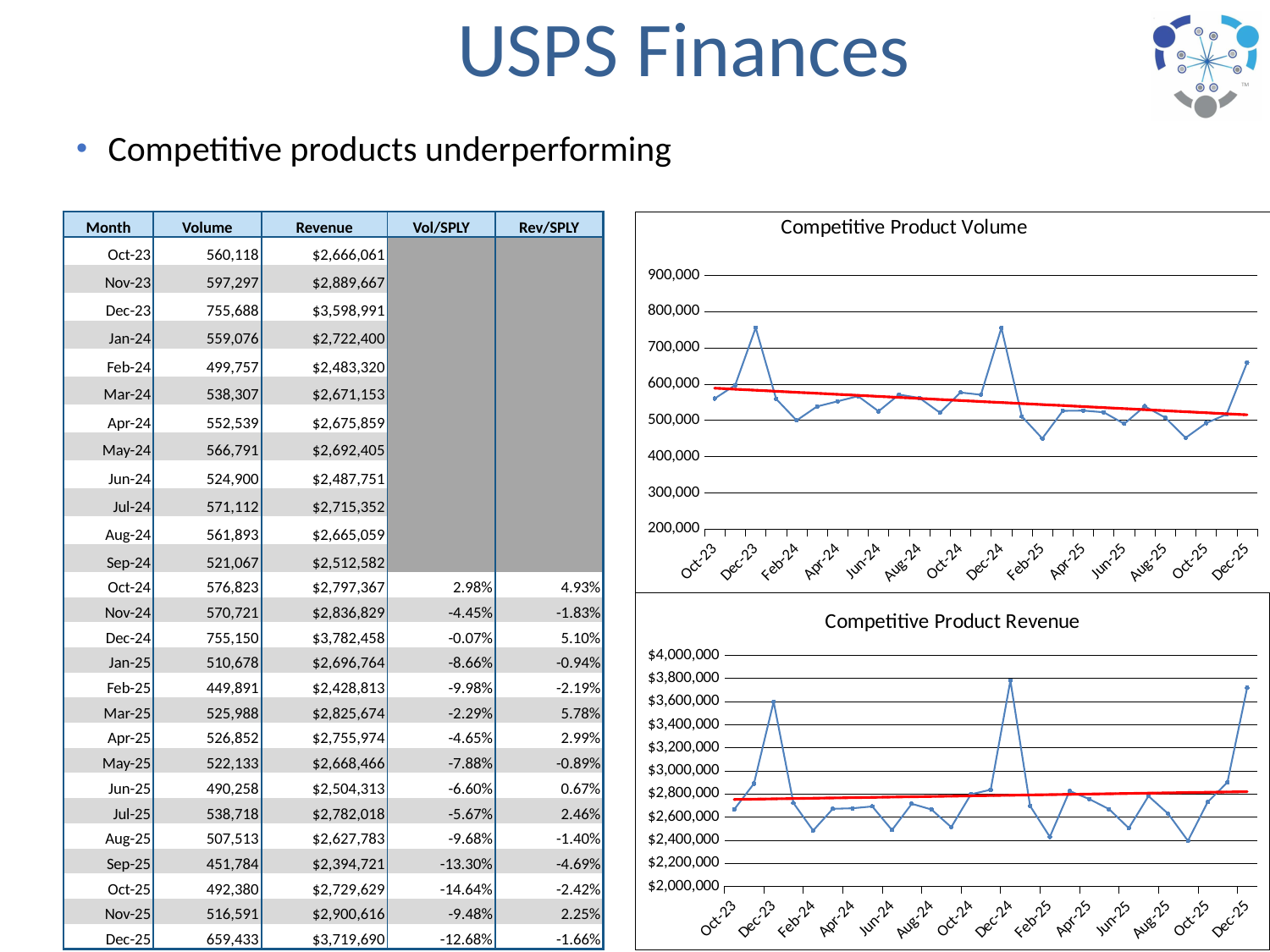
On the Competitive Product Revenue chart, does the red trend line rise or fall from Oct-23 to Dec-25? Rises On the Competitive Product Revenue chart, which is larger, the value for Dec-24 or the value for Jan-25? Dec-24 How many monthly data points are plotted on the Competitive Product Volume chart? 27 What is the competitive product volume for Dec-25 as shown on the slide? 659,433 On the Competitive Product Volume chart, does the red trend line rise or fall from Oct-23 to Dec-25? Falls On the Competitive Product Revenue chart, is the value for Dec-24 greater or less than $3,600,000? greater On the Competitive Product Revenue chart, is the value for Feb-24 greater or less than $2,600,000? less On the Competitive Product Volume chart, which is larger, the value for Dec-23 or the value for Feb-25? Dec-23 What kind of chart is the Competitive Product Volume chart? Line chart What is the lowest value shown on the y-axis of the Competitive Product Revenue chart? $2,000,000 On the Competitive Product Volume chart, is the value for Feb-25 greater or less than 500,000? less